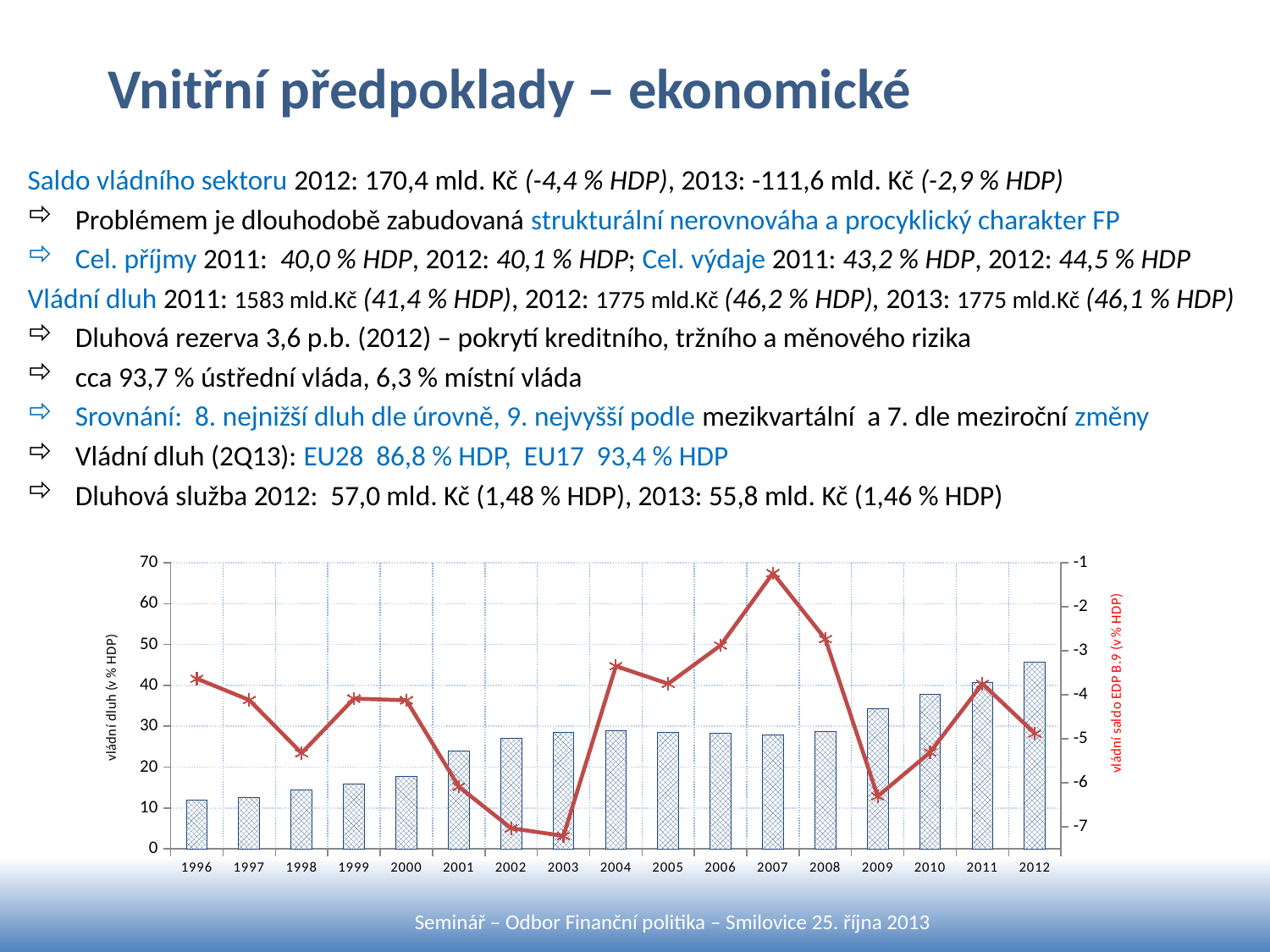
Which year has the highest bar (vládní dluh) in the chart? 2012 How many years are shown on the x axis of the chart? 17 Is the bar value for 2009 greater or less than 30? greater In which year does the line (vládní saldo EDP B.9) reach its highest point? 2007 What kind of chart is shown on the slide? A combined bar and line chart What is the title of the left vertical axis? vládní dluh (v % HDP) Is the bar value for 2012 greater or less than 40? greater Which year has the larger bar, 2004 or 2012? 2012 Which year has the lowest bar (vládní dluh) in the chart? 1996 Is the bar value for 1996 greater or less than 20? less Do the bars rise or fall from 2008 to 2012? rise What is the title of the right vertical axis? vládní saldo EDP B.9 (v % HDP)